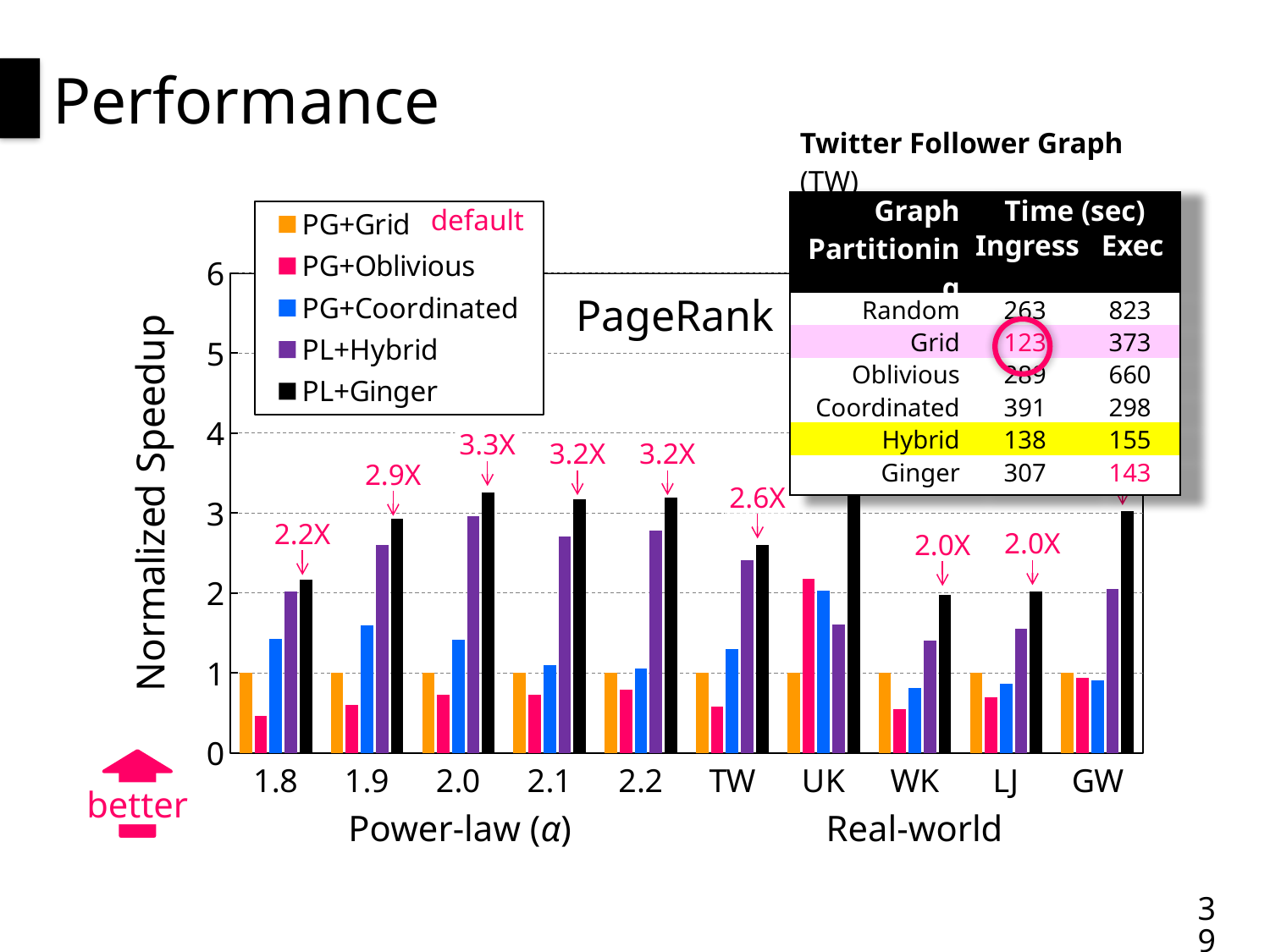
How many series does the chart legend list? 5 What is the labeled speedup for PL+Ginger on the TW graph? 2.6X What is the title of the y axis of the chart? Normalized Speedup Which series has the lowest bar for the 1.8 category? PG+Oblivious What is the labeled speedup for PL+Ginger at power-law α = 1.8? 2.2X What is the labeled speedup for PL+Ginger at power-law α = 2.0? 3.3X Which is larger, the PL+Ginger speedup at α = 1.9 or at α = 2.0? α = 2.0 What is the difference between the PL+Ginger speedup at α = 2.0 and at α = 1.8? 1.1X What type of chart is shown on the slide? bar chart Is the PL+Hybrid value at α = 1.8 greater or less than 3? less How many categories are shown along the x axis of the chart? 10 Which series has the highest bar for the UK category? PL+Ginger